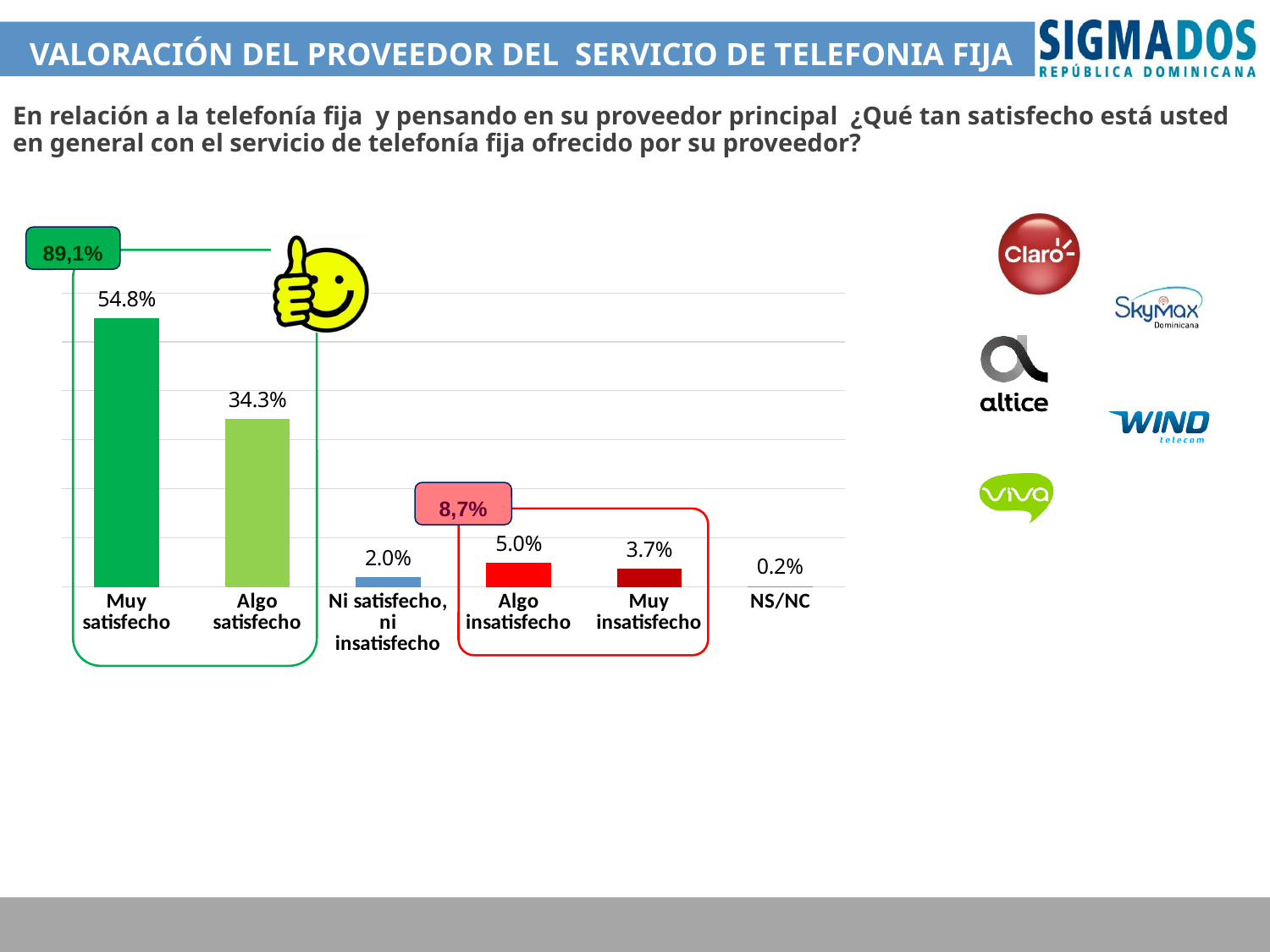
What is the value for Muy insatisfecho? 3.7% What is the value for NS/NC? 0.2% What is the difference between Muy satisfecho and Algo satisfecho? 20.5% Which category has the lowest value? NS/NC What is the value for Ni satisfecho, ni insatisfecho? 2.0% Which is larger, Algo insatisfecho or Muy insatisfecho? Algo insatisfecho Which category has the highest value? Muy satisfecho What is the value for Muy satisfecho? 54.8% How many categories are shown on the x axis? 6 What kind of chart is shown? Bar chart What is the value for Algo satisfecho? 34.3% What combined percentage is shown in the green callout box above the satisfied categories? 89,1%